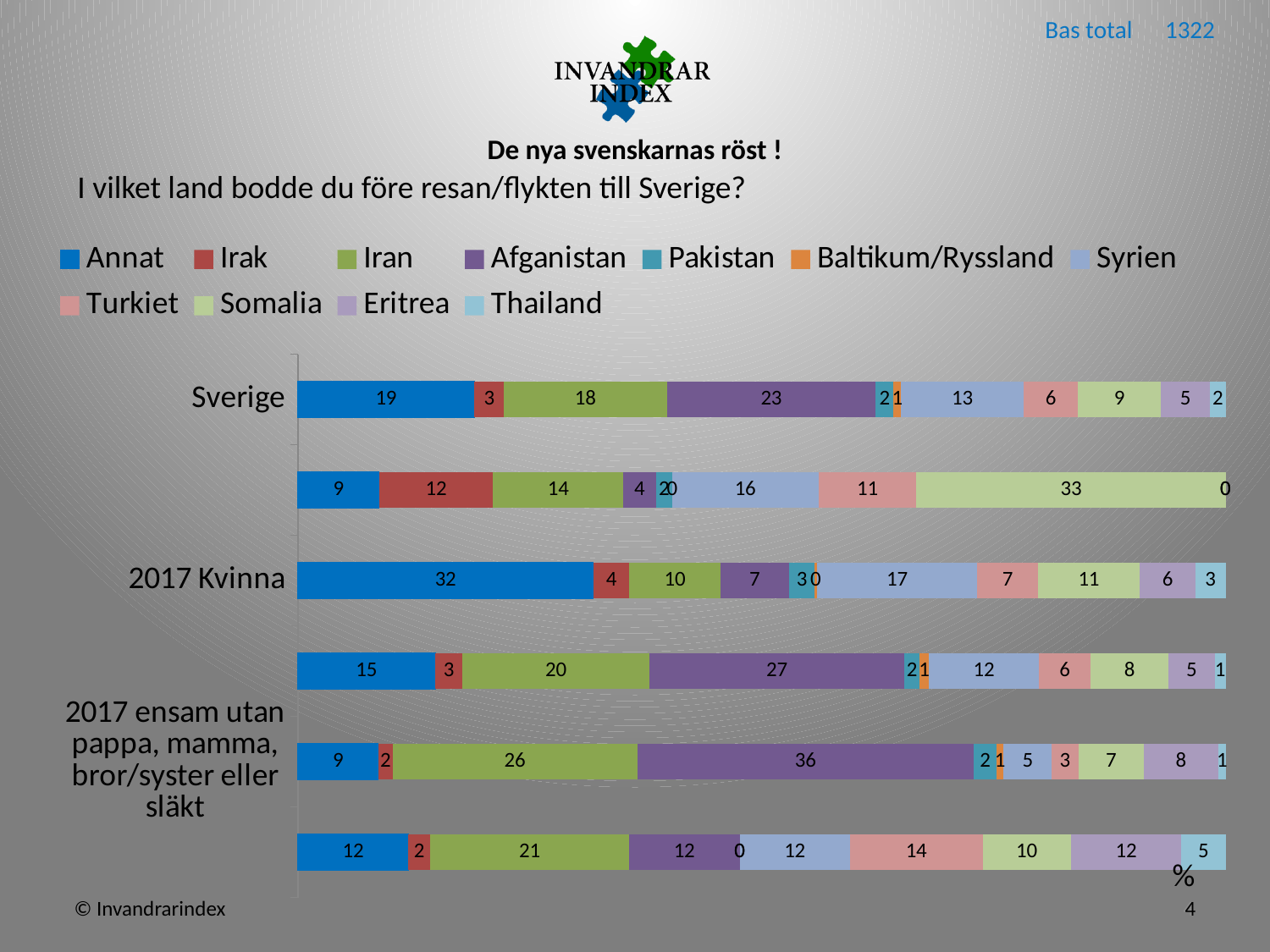
Which series is listed first in the legend? Annat What is the value for Annat in the 2017 Kvinna bar? 32 Which series has the largest value in the 2017 Kvinna bar? Annat What is the difference between the Iran and Irak values in the Sverige bar? 15 How many bars are plotted in the chart? 6 Which series has the largest value in the Sverige bar? Afganistan What kind of chart is shown on the slide? Stacked bar chart How many series does the legend list? 11 In the '2017 ensam utan pappa, mamma, bror/syster eller släkt' bar, which is larger: Iran or Annat? Iran What is the value for Afganistan in the '2017 ensam utan pappa, mamma, bror/syster eller släkt' bar? 36 What is the value for Afganistan in the Sverige bar? 23 What is the value for Syrien in the 2017 Kvinna bar? 17